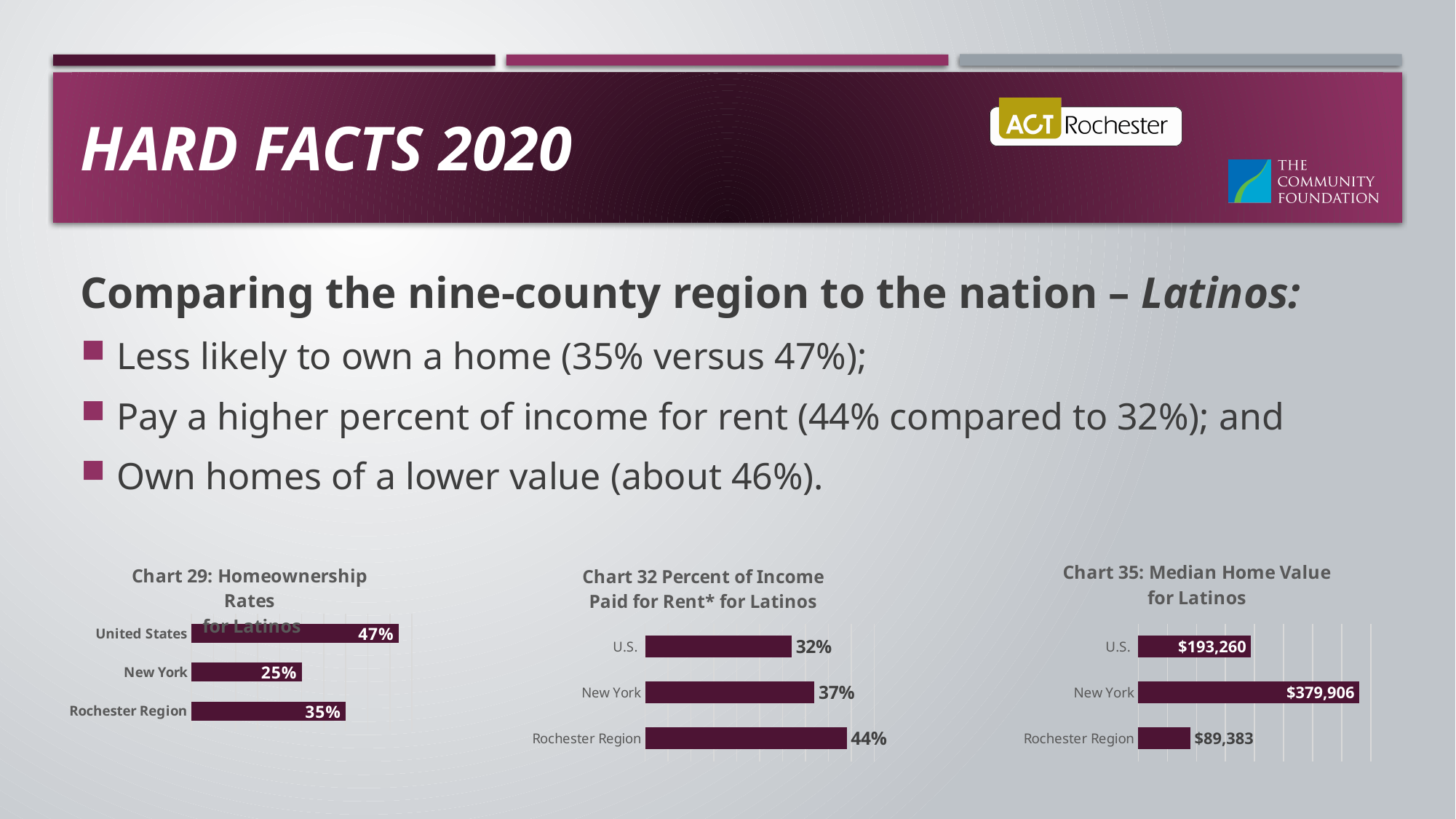
In Chart 32 Percent of Income Paid for Rent* for Latinos, what is the value for Rochester Region? 44% In Chart 32 Percent of Income Paid for Rent* for Latinos, which category has the lowest value? U.S. In Chart 35: Median Home Value for Latinos, what is the difference between the U.S. and Rochester Region values? $103,877 How many categories are shown in Chart 32 Percent of Income Paid for Rent* for Latinos? 3 In Chart 29: Homeownership Rates for Latinos, what is the value for New York? 25% In Chart 35: Median Home Value for Latinos, which category has the lowest value? Rochester Region In Chart 29: Homeownership Rates for Latinos, which category has the highest value? United States In Chart 29: Homeownership Rates for Latinos, what is the difference between the United States and Rochester Region values? 12% In Chart 35: Median Home Value for Latinos, what is the value for New York? $379,906 In Chart 32 Percent of Income Paid for Rent* for Latinos, which is larger, New York or U.S.? New York In Chart 35: Median Home Value for Latinos, what is the value for Rochester Region? $89,383 What kind of chart is Chart 29: Homeownership Rates for Latinos? Bar chart